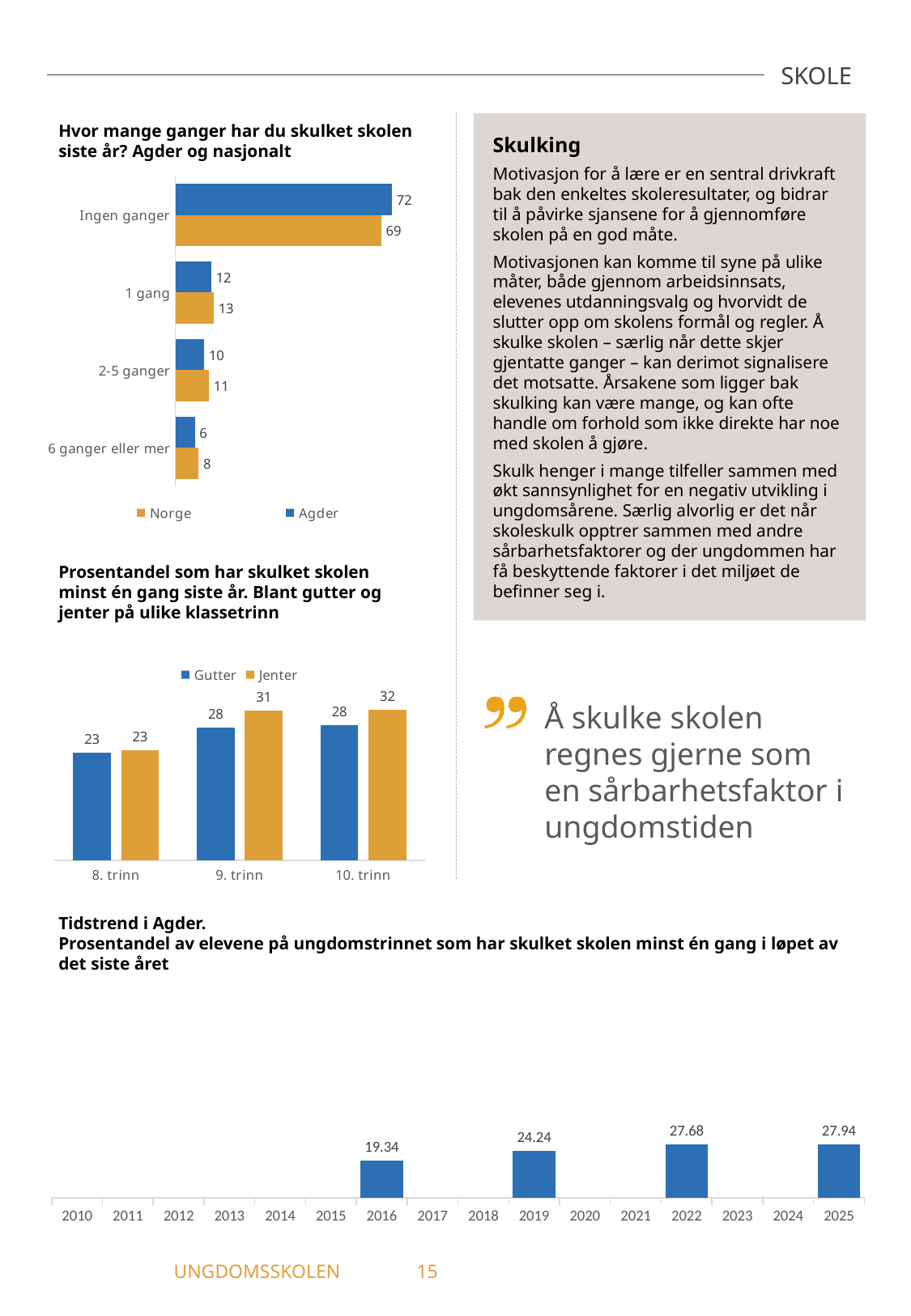
In the chart 'Tidstrend i Agder', what is the value for 2019? 24.24 In the chart 'Hvor mange ganger har du skulket skolen siste år? Agder og nasjonalt', how many series does the legend list? 2 In the chart 'Hvor mange ganger har du skulket skolen siste år? Agder og nasjonalt', what is the value for Agder in the category 'Ingen ganger'? 72 In the chart 'Prosentandel som har skulket skolen minst én gang siste år', what is the value for Jenter at 10. trinn? 32 What kind of chart is 'Hvor mange ganger har du skulket skolen siste år? Agder og nasjonalt'? Bar chart In the chart 'Tidstrend i Agder', do the values rise or fall from 2016 to 2025? Rise In the chart 'Prosentandel som har skulket skolen minst én gang siste år', how many categories are shown on the x axis? 3 In the chart 'Tidstrend i Agder', which year has the highest value? 2025 In the chart 'Prosentandel som har skulket skolen minst én gang siste år', which is larger at 9. trinn, Gutter or Jenter? Jenter In the chart 'Hvor mange ganger har du skulket skolen siste år? Agder og nasjonalt', what is the difference between the Agder and Norge values for 'Ingen ganger'? 3 In the chart 'Hvor mange ganger har du skulket skolen siste år? Agder og nasjonalt', which category has the lowest value for Agder? 6 ganger eller mer In the chart 'Hvor mange ganger har du skulket skolen siste år? Agder og nasjonalt', what is the value for Norge in the category '6 ganger eller mer'? 8